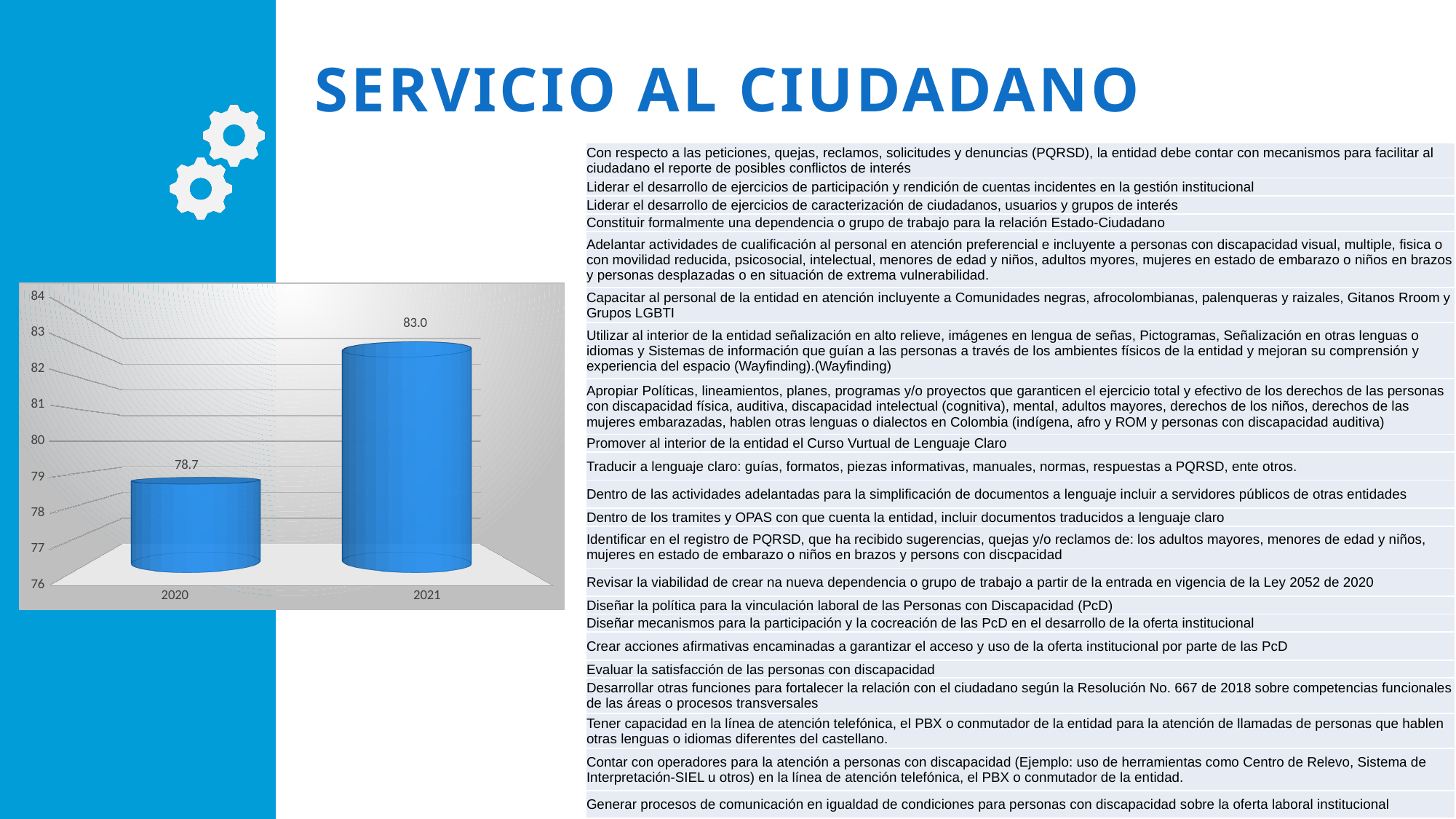
Is the value for 2021 greater or less than 82? greater What kind of chart is shown on the slide? bar chart What is the value for 2021? 83.0 What is the value for 2020? 78.7 Which year has the highest value? 2021 What is the difference between the values for 2021 and 2020? 4.3 Which year has the lowest value? 2020 Is the value for 2020 greater or less than 80? less How many categories are shown on the x axis of the chart? 2 Which is larger, the value for 2020 or the value for 2021? 2021 What is the lowest value shown on the vertical axis of the chart? 76 Do the values rise or fall from 2020 to 2021? rise